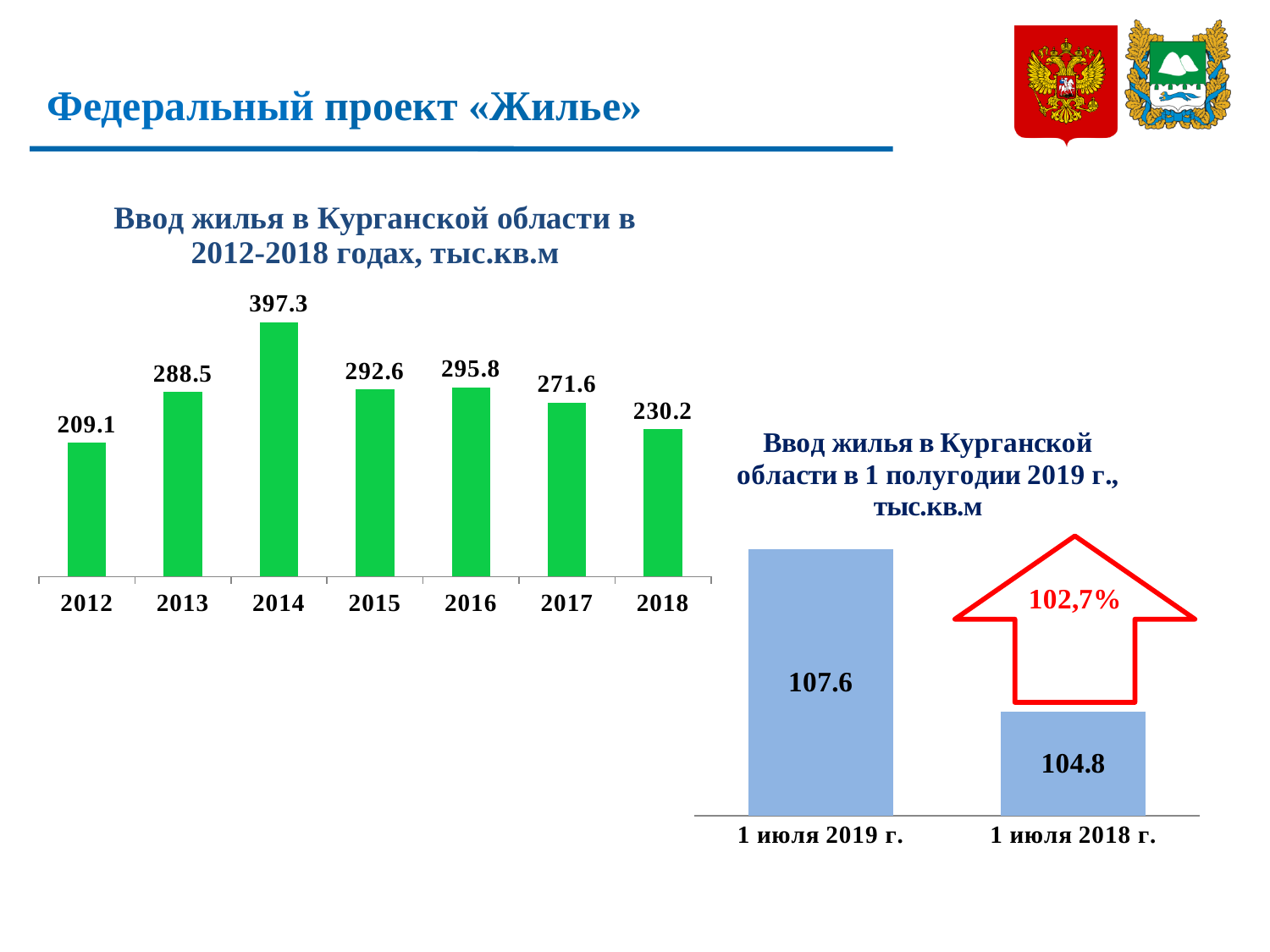
In the right chart (Ввод жилья в Курганской области в 1 полугодии 2019 г.), what is the value for 1 июля 2019 г.? 107.6 What kind of chart is the left chart (Ввод жилья в Курганской области в 2012-2018 годах)? bar chart In the left chart (Ввод жилья в Курганской области в 2012-2018 годах), what is the difference between the values for 2014 and 2012? 188.2 In the left chart (Ввод жилья в Курганской области в 2012-2018 годах), which year has the highest value? 2014 In the left chart (Ввод жилья в Курганской области в 2012-2018 годах), what is the value for 2014? 397.3 In the left chart (Ввод жилья в Курганской области в 2012-2018 годах), what is the value for 2018? 230.2 In the right chart (Ввод жилья в Курганской области в 1 полугодии 2019 г.), what percentage is shown inside the red arrow? 102,7% In the left chart (Ввод жилья в Курганской области в 2012-2018 годах), which is larger, the value for 2013 or the value for 2017? 2013 In the left chart (Ввод жилья в Курганской области в 2012-2018 годах), which year has the lowest value? 2012 In the right chart (Ввод жилья в Курганской области в 1 полугодии 2019 г.), what is the difference between the values for 1 июля 2019 г. and 1 июля 2018 г.? 2.8 In the left chart (Ввод жилья в Курганской области в 2012-2018 годах), do the values rise or fall from 2016 to 2018? fall In the left chart (Ввод жилья в Курганской области в 2012-2018 годах), how many years are shown? 7